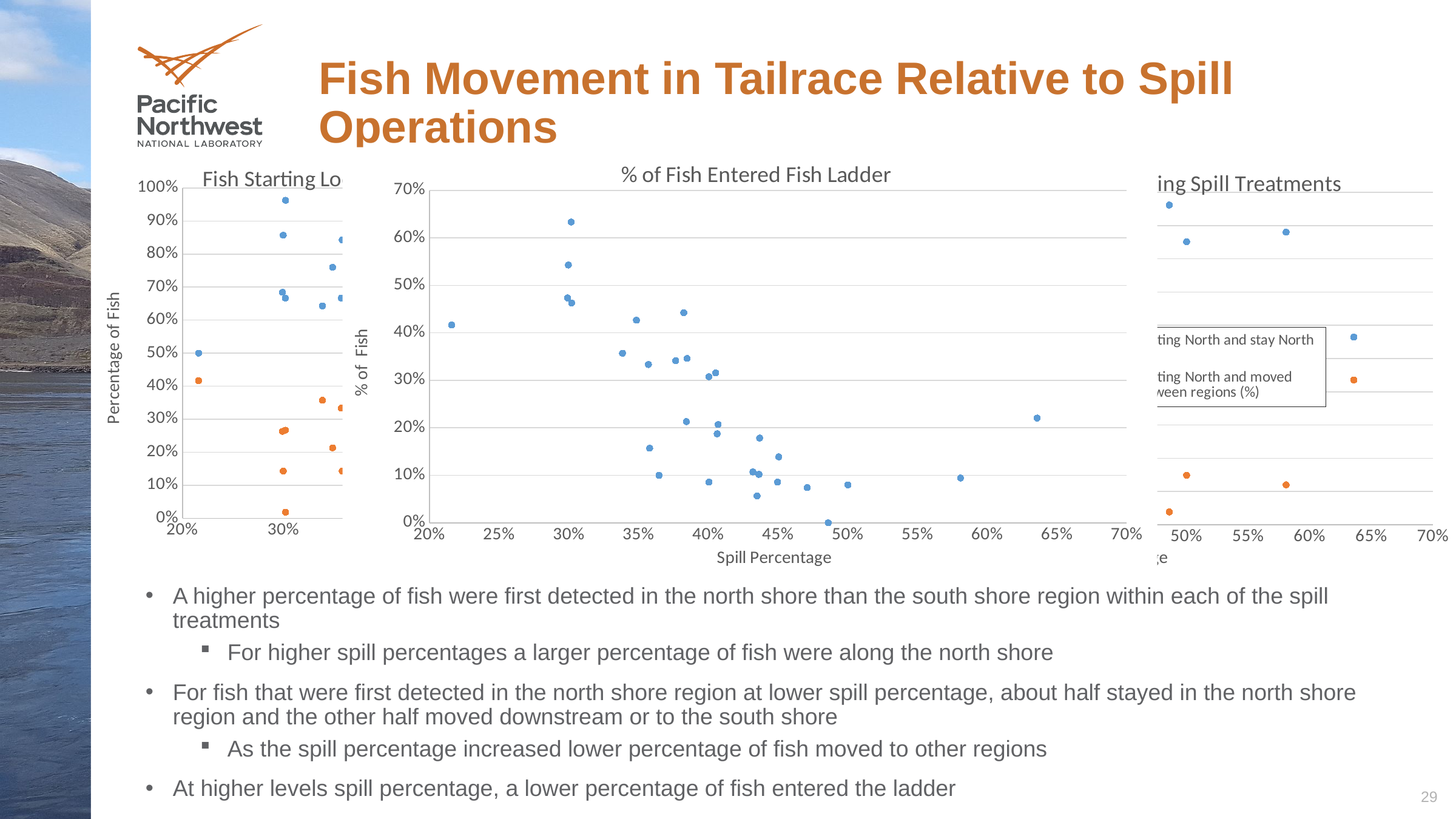
In the '% of Fish Entered Fish Ladder' chart, is the value for the point near 63% spill greater or less than 30%? less In the '% of Fish Entered Fish Ladder' chart, what is the y-axis title? % of Fish In the '% of Fish Entered Fish Ladder' chart, do the values generally rise or fall as spill percentage increases? fall In the '% of Fish Entered Fish Ladder' chart, is the value for the point near 58% spill greater or less than 20%? less In the '% of Fish Entered Fish Ladder' chart, is the highest plotted value greater or less than 60%? greater In the '% of Fish Entered Fish Ladder' chart, what is the maximum value shown on the y axis? 70% In the '% of Fish Entered Fish Ladder' chart, what is the x-axis title? Spill Percentage What kind of chart is the '% of Fish Entered Fish Ladder' chart? scatter chart In the '% of Fish Entered Fish Ladder' chart, which is larger: the value for the point near 30% spill at the top of the chart or the value for the point near 50% spill? the point near 30% spill